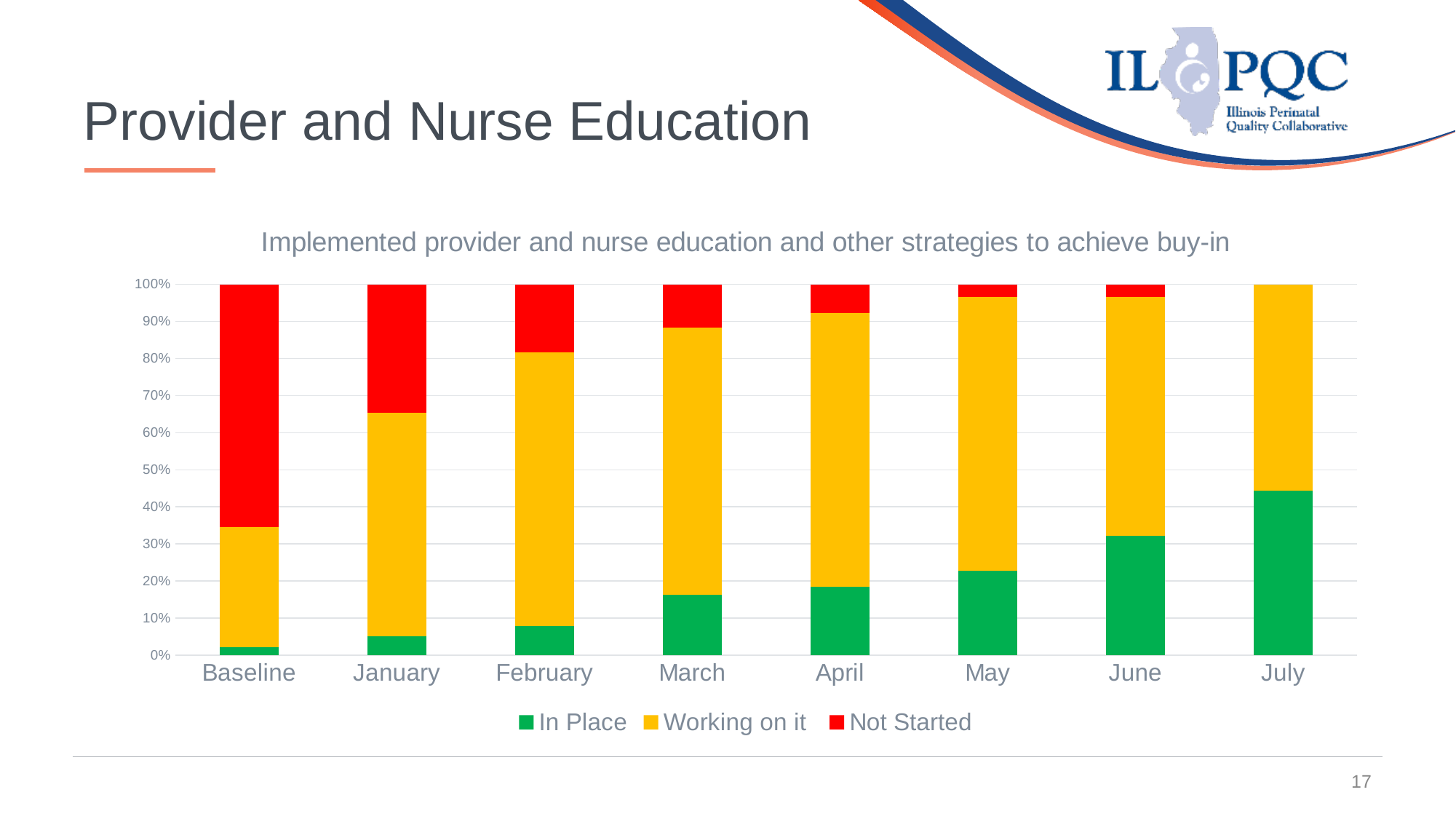
Is the In Place value for March greater or less than 20%? less Do the In Place values rise or fall from Baseline to July? rise Which category has the highest Not Started value? Baseline Which has the larger In Place value, March or June? June How many categories are shown along the x axis of the chart? 8 How many series does the chart's legend list? 3 What kind of chart is shown on the slide? bar chart What is the total of the stacked bar for July? 100% Is the In Place value for July greater or less than 40%? greater Which category has the highest In Place value? July What is the title of the chart? Implemented provider and nurse education and other strategies to achieve buy-in Which category has the lowest In Place value? Baseline